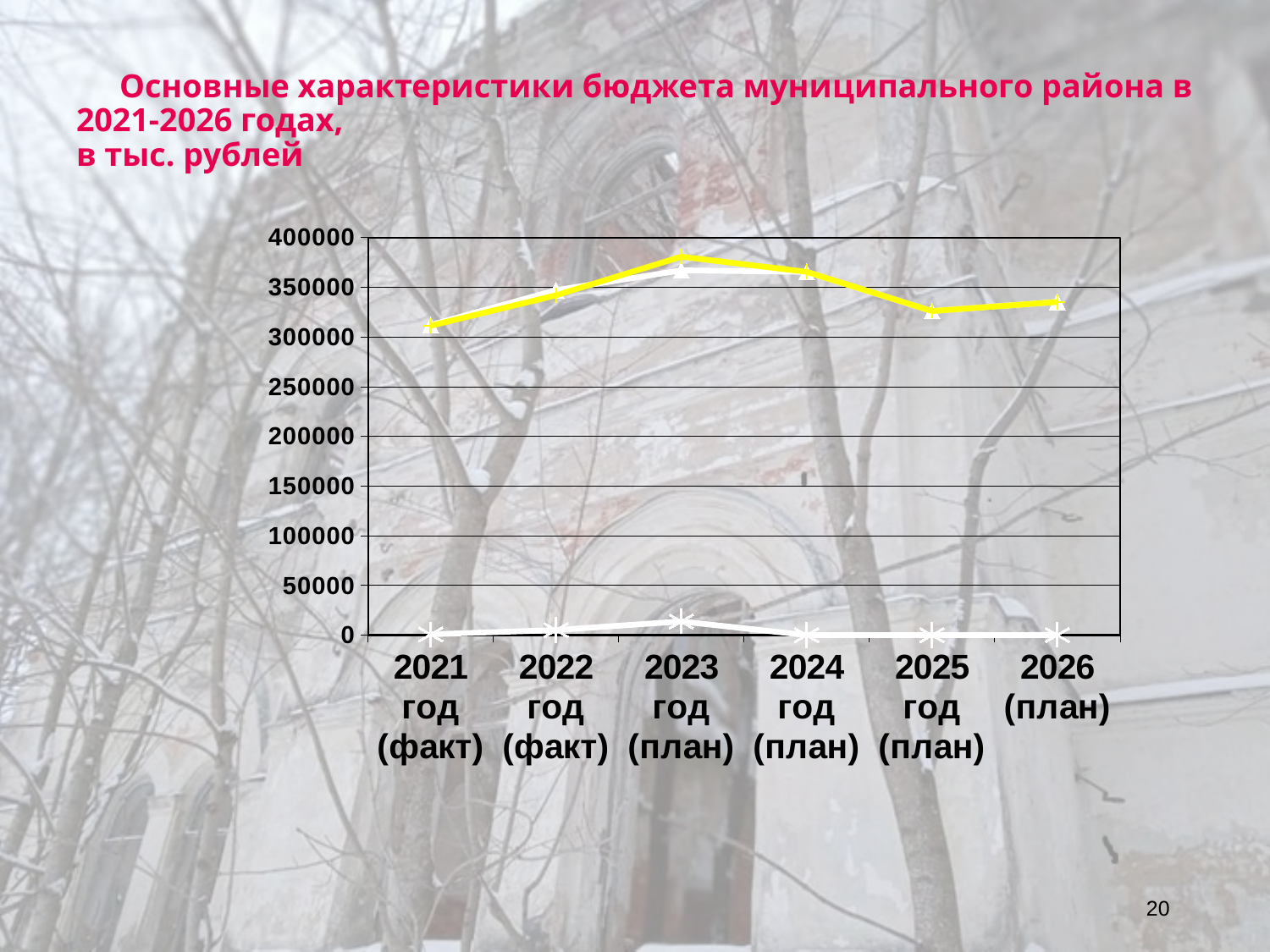
In which year does the yellow line have its lowest value? 2021 год (факт) Is the value of the lowest line (with x markers) for 2023 год (план) greater or less than 50000? less Which is larger on the yellow line: the value for 2023 год (план) or the value for 2025 год (план)? 2023 год (план) Is the value of the yellow line for 2021 год (факт) greater or less than 300000? greater How many categories (years) are shown on the x axis of the chart? 6 What is the title of the chart on the slide? Основные характеристики бюджета муниципального района в 2021-2026 годах, в тыс. рублей Is the value of the yellow line for 2023 год (план) greater or less than 350000? greater Does the yellow line rise or fall from 2021 год (факт) to 2023 год (план)? rise How many lines are plotted on the chart? 3 In which year does the yellow line reach its highest value? 2023 год (план) What kind of chart is shown on the slide? line chart